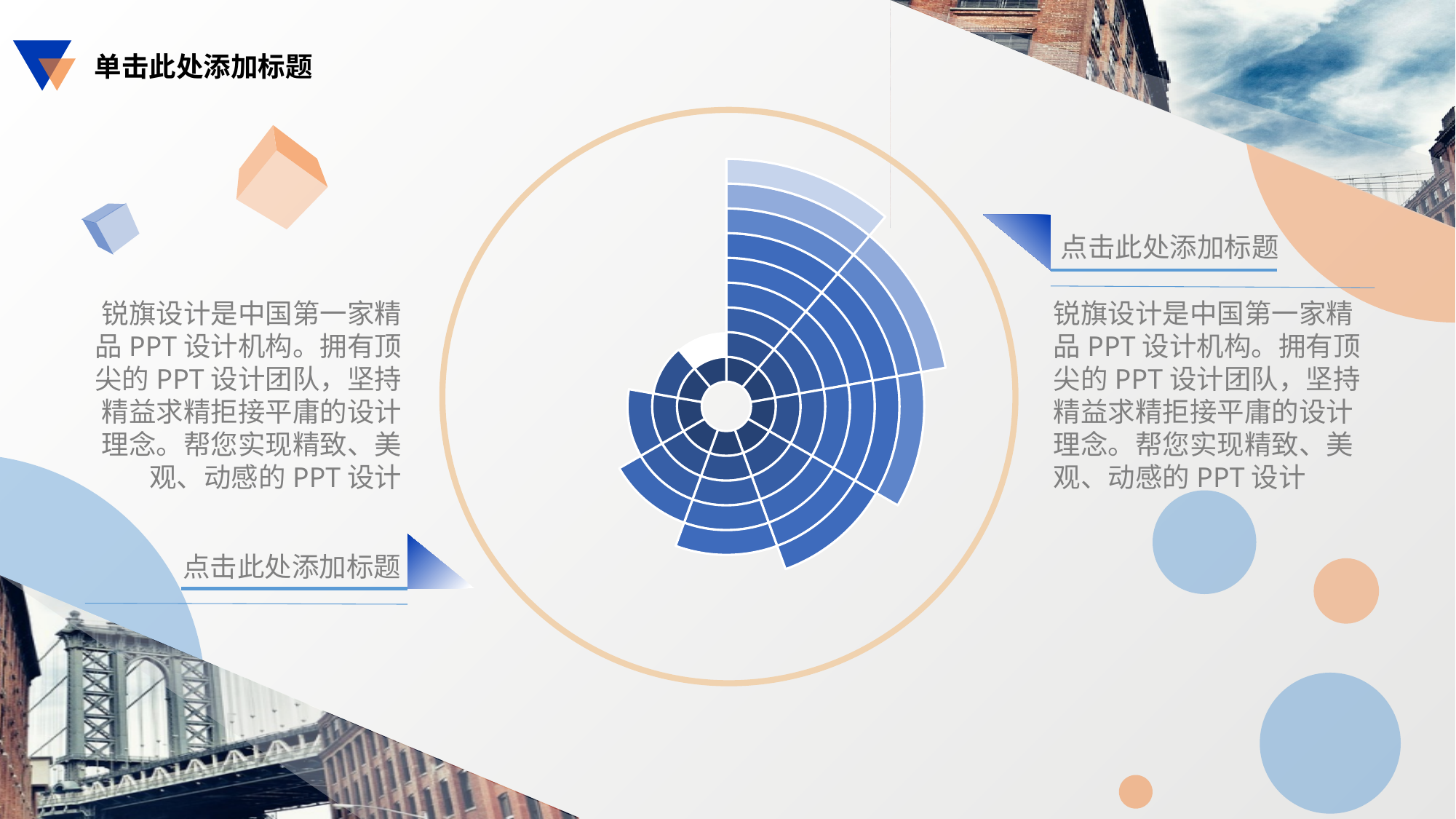
What colour are the bars in the radial chart? blue Which segment of the radial chart extends farthest from the centre? the top (12 o'clock) segment What kind of chart is shown in the centre of the slide? radial bar chart